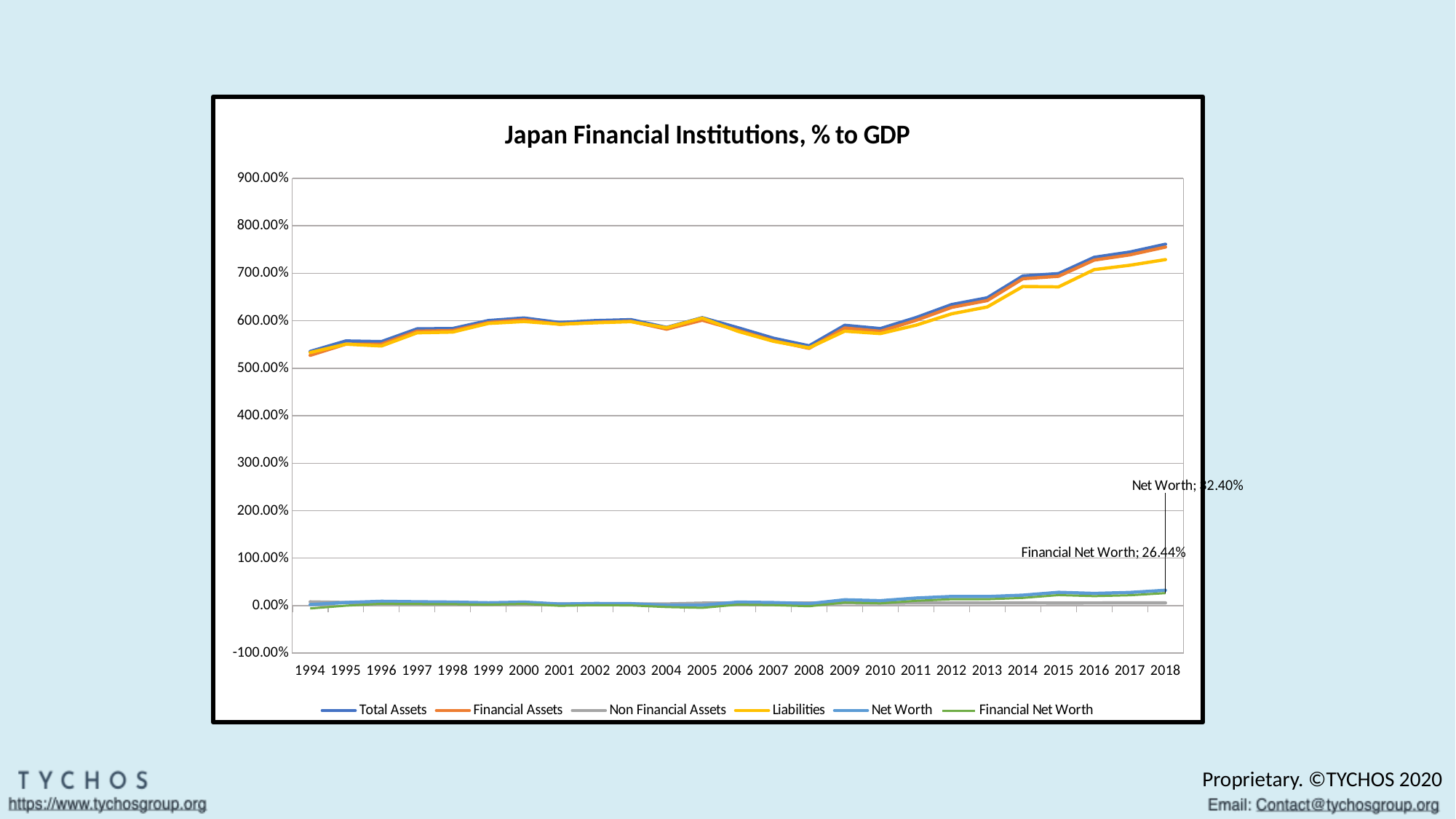
Is the value for Total Assets in 2018 greater or less than 700.00%? greater How many years are plotted along the x axis? 25 What is the value of Financial Net Worth in 2018? 26.44% What is the title of the chart? Japan Financial Institutions, % to GDP How many series does the legend list? 6 Do the Total Assets values rise or fall from 2008 to 2018? rise Is the value for Liabilities in 2008 greater or less than 600.00%? less In which year is Total Assets at its highest? 2018 Is the value for Total Assets in 1994 greater or less than 600.00%? less In 2018, which is larger: Total Assets or Non Financial Assets? Total Assets What kind of chart is shown on the slide? line chart